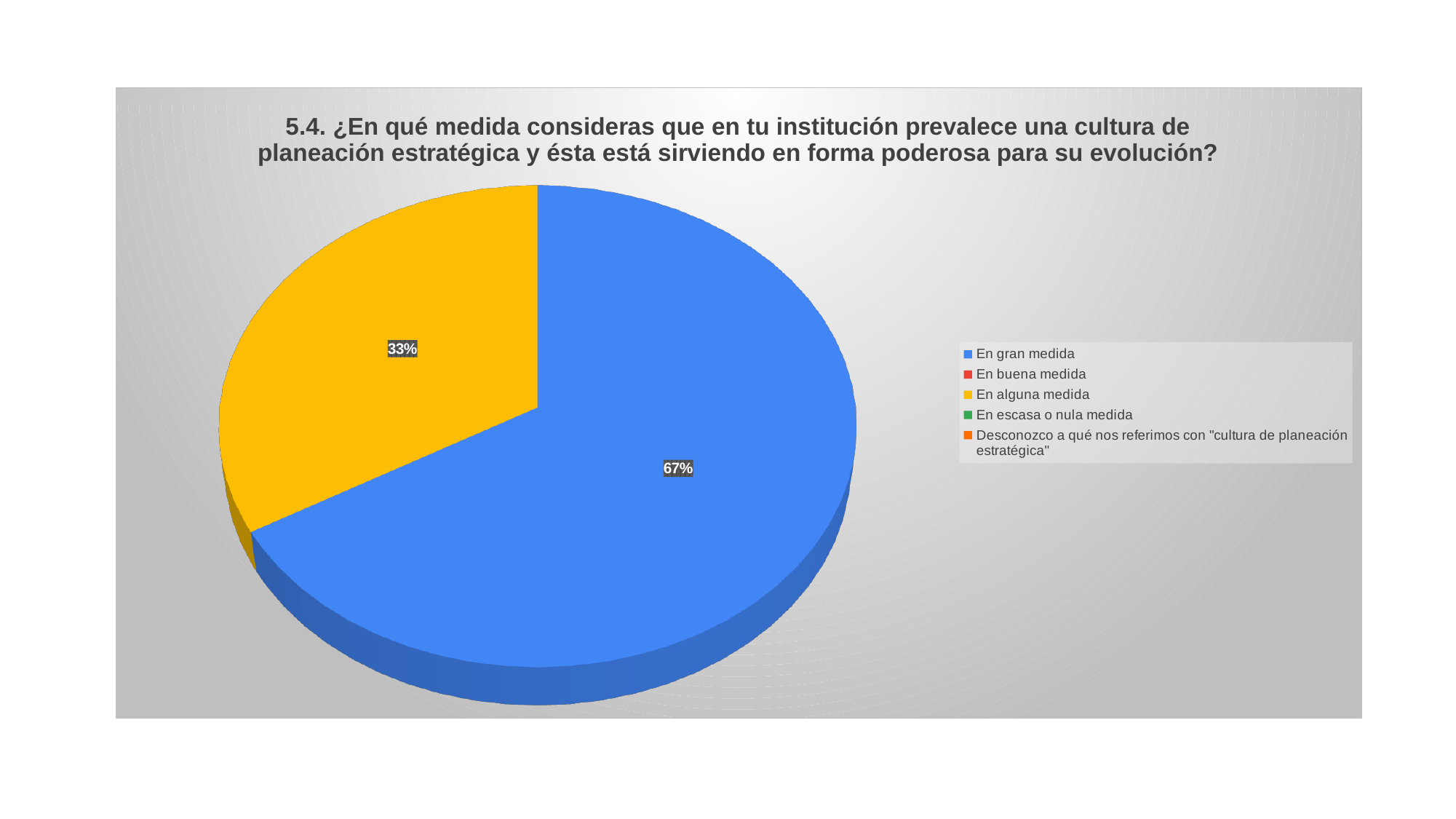
Is the share for "En gran medida" greater or less than 50%? greater What share of the pie does "En alguna medida" represent? 33% What colour is the slice for "En gran medida"? Blue What kind of chart is shown on the slide? Pie chart What is the difference in percentage points between the "En gran medida" slice and the "En alguna medida" slice? 34 percentage points Which category has the largest slice of the pie? En gran medida What colour is the slice for "En alguna medida"? Yellow How many entries does the legend list? 5 Which of the two visible slices is larger, "En gran medida" or "En alguna medida"? En gran medida Is the share for "En alguna medida" greater or less than 50%? less How many slices are visible in the pie? 2 What share of the pie does "En gran medida" represent? 67%